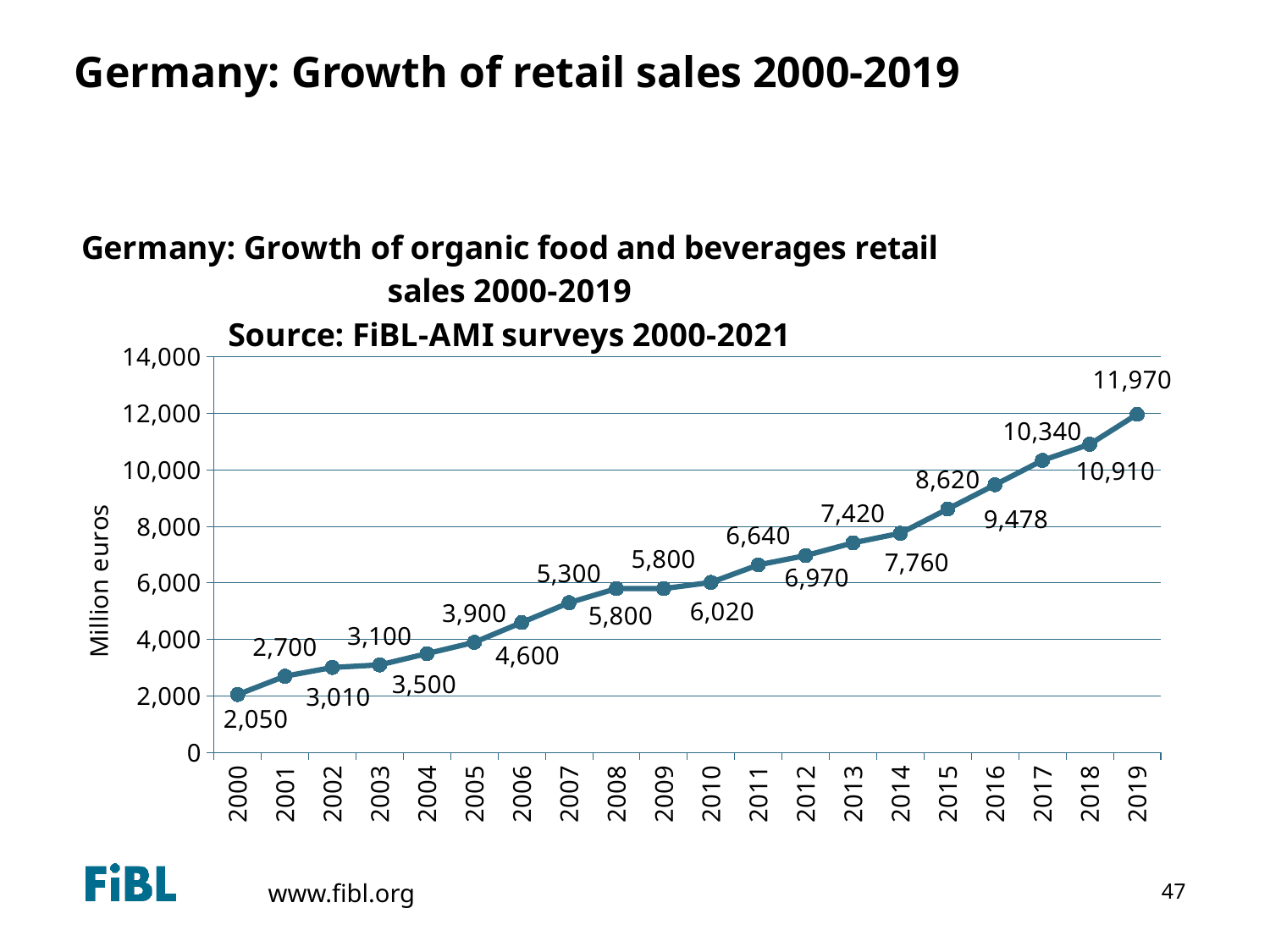
How many data points are plotted on the line? 20 What was the value of retail sales in 2016? 9,478 What is the difference between the retail sales values for 2019 and 2018? 1,060 Which year has the lowest retail sales value? 2000 What is the label of the vertical axis? Million euros Which year has the highest retail sales value? 2019 What was the value of organic food and beverages retail sales in Germany in 2019? 11,970 Which year has the larger retail sales value, 2015 or 2013? 2015 What was the value of retail sales in 2010? 6,020 Do the retail sales values generally rise or fall from 2000 to 2019? Rise What was the value of retail sales in 2000? 2,050 What type of chart is shown on the slide? Line chart